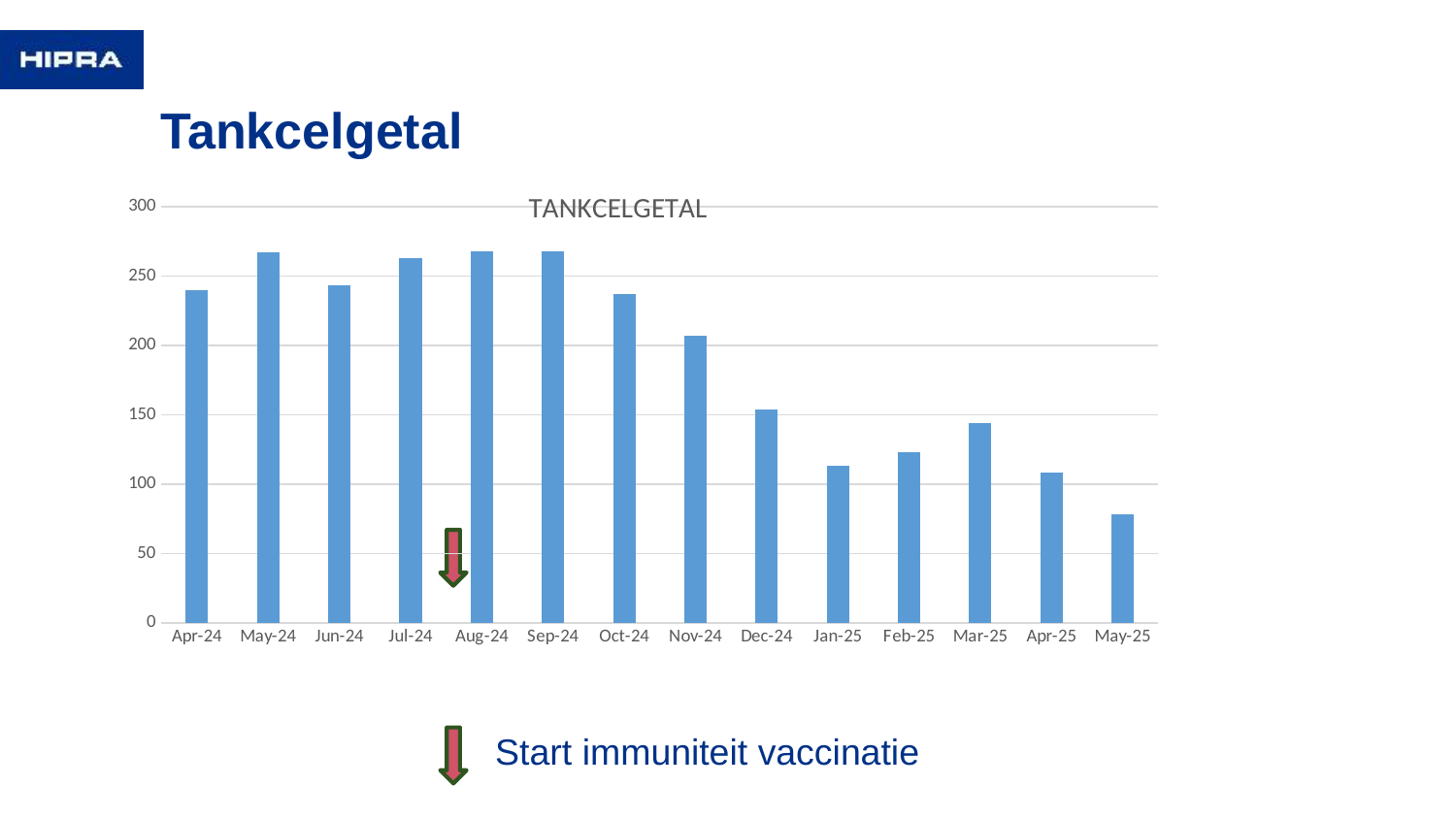
What is the title printed inside the chart area? TANKCELGETAL Do the values generally rise or fall from Sep-24 to May-25? fall Which month has the lowest value in the chart? May-25 Is the value for Jan-25 greater or less than 100? greater Is the value for May-25 greater or less than 100? less Which is larger, the value for Apr-24 or the value for Nov-24? Apr-24 Which is larger, the value for Nov-24 or the value for Dec-24? Nov-24 How many months are shown on the x axis of the chart? 14 What kind of chart is shown on the slide? bar chart Is the value for Sep-24 greater or less than 250? greater